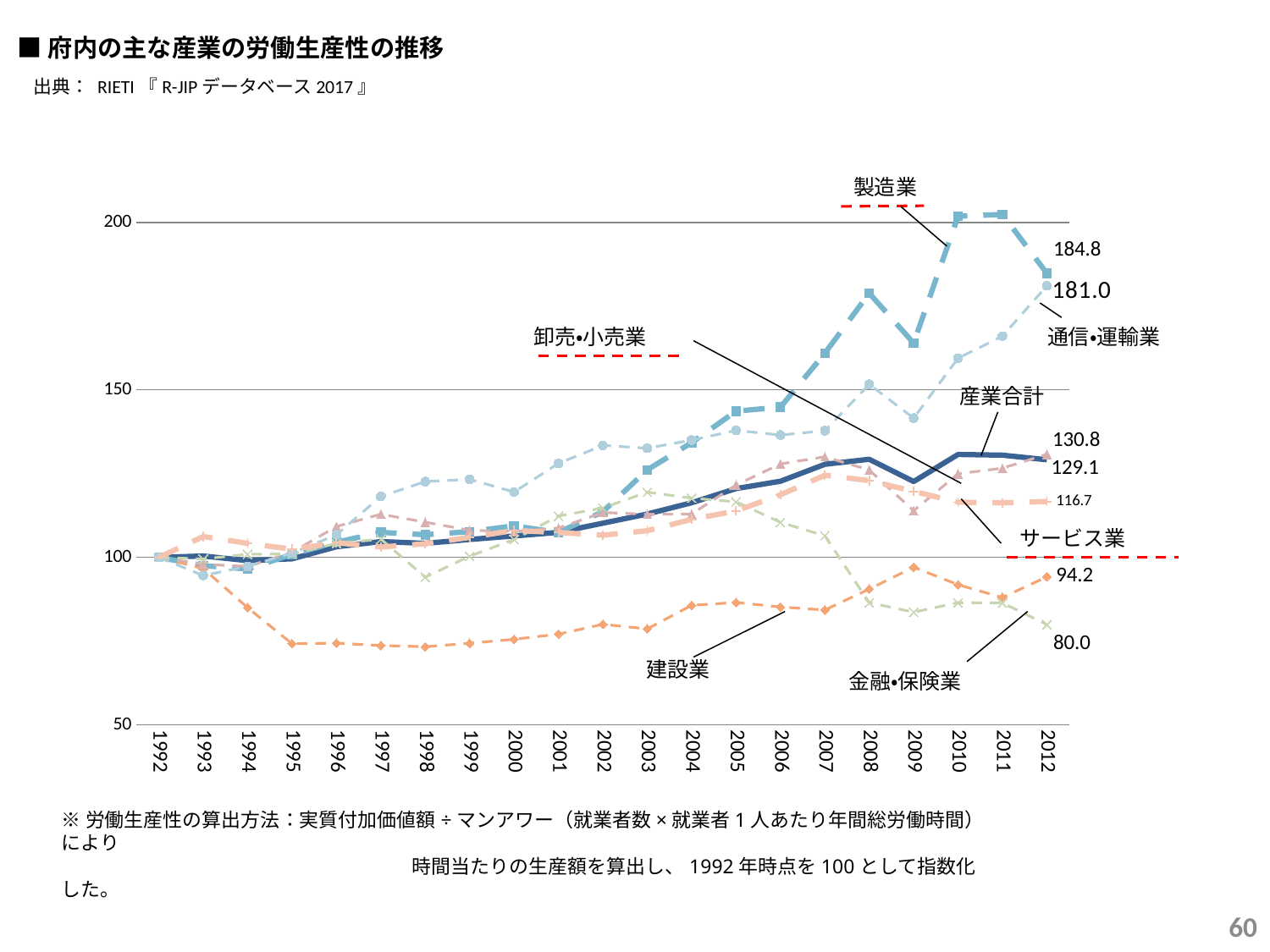
What is the 2012 value for 製造業? 184.8 Is the value for 建設業 in 1995 greater or less than 100? less What kind of chart is shown on the slide? line chart Which industry has the highest value in 2012? 製造業 What is the 2012 value for 通信・運輸業? 181.0 Does the 製造業 line generally rise or fall from 1992 to 2012? rise What is the difference between the 2012 values of 製造業 and 通信・運輸業? 3.8 Which industry has the lowest value in 2012? 金融・保険業 What is the 2012 value for サービス業? 116.7 What is the 2012 value for 建設業? 94.2 How many years are shown on the x axis? 21 What is the 2012 value for 金融・保険業? 80.0